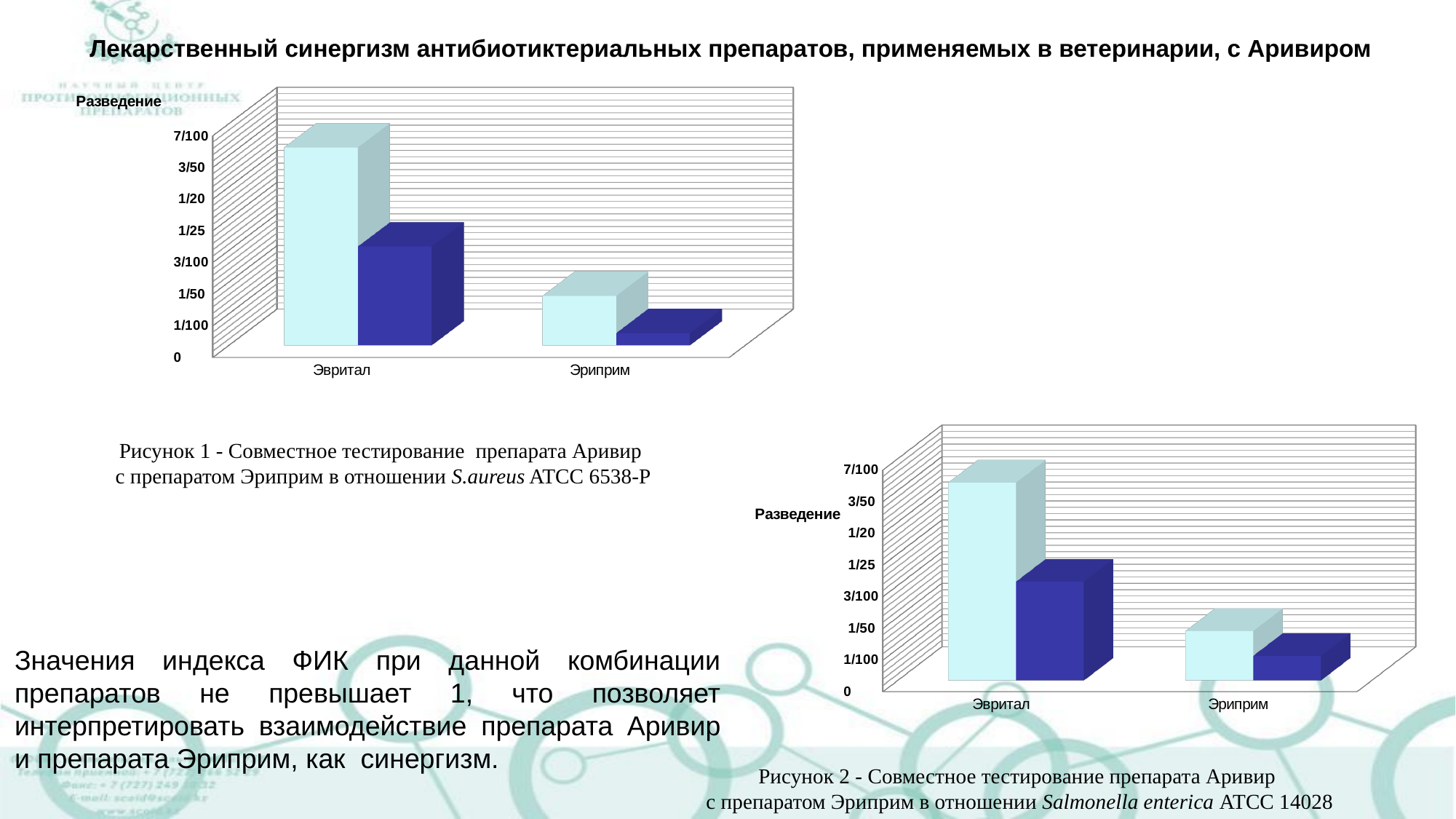
What kind of chart is shown in Рисунок 2 (bottom-right chart)? bar chart In the bottom-right chart (Рисунок 2), which category has the tallest bar? Эвритал What is the title of the vertical axis in the top chart (Рисунок 1)? Разведение How many categories are shown on the x axis of the bottom-right chart (Рисунок 2)? 2 In the bottom-right chart (Рисунок 2), is the dark blue bar for Эриприм taller or shorter than the dark blue bar for Эвритал? shorter How many categories are shown on the x axis of the top chart (Рисунок 1)? 2 In the top chart (Рисунок 1), which category has the tallest bar? Эвритал In the top chart (Рисунок 1), is the light blue bar for Эвритал taller or shorter than the light blue bar for Эриприм? taller In the top chart (Рисунок 1), is the light blue bar for Эвритал greater or less than the 1/20 tick on the axis? greater In the bottom-right chart (Рисунок 2), is the light blue bar for Эриприм greater or less than the 1/20 tick on the axis? less How many bars are drawn for each category in the bottom-right chart (Рисунок 2)? 2 What kind of chart is shown in Рисунок 1 (top chart)? bar chart